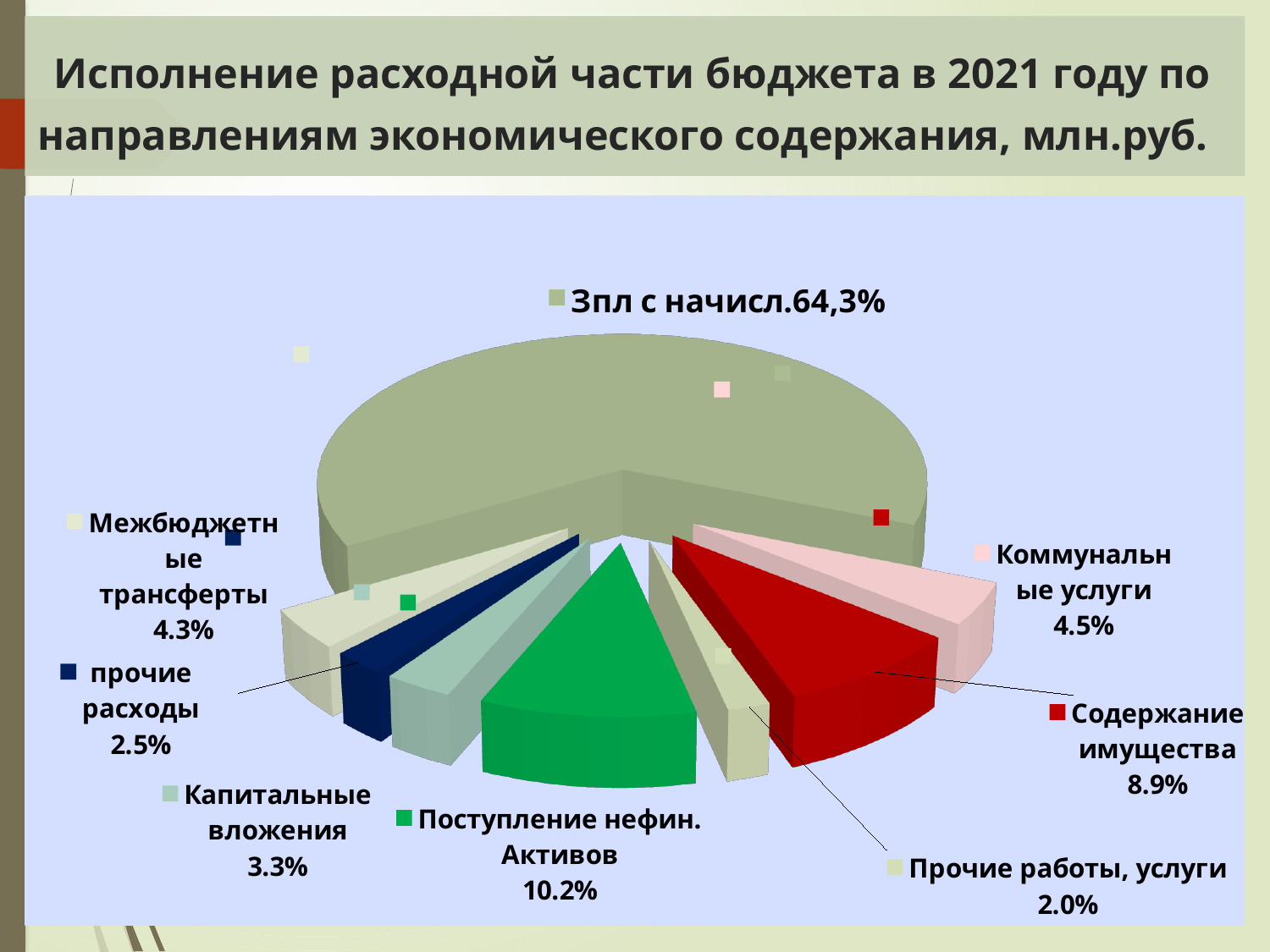
What kind of chart is shown on the slide? Pie chart What is the value shown for "Коммунальные услуги"? 4.5% What is the value shown for "Поступление нефин. Активов"? 10.2% Which is larger: "Межбюджетные трансферты" or "Капитальные вложения"? Межбюджетные трансферты What is the value shown for "Прочие работы, услуги"? 2.0% Which category has the smallest share of the pie? Прочие работы, услуги What share of the pie does "Зпл с начисл." take? 64,3% What is the title of the slide containing the chart? Исполнение расходной части бюджета в 2021 году по направлениям экономического содержания, млн.руб. How many categories (slices) does the pie chart have? 8 What is the value shown for "Содержание имущества"? 8.9% What is the difference between the shares of "Поступление нефин. Активов" and "Содержание имущества"? 1.3% Which category has the largest share of the pie? Зпл с начисл.